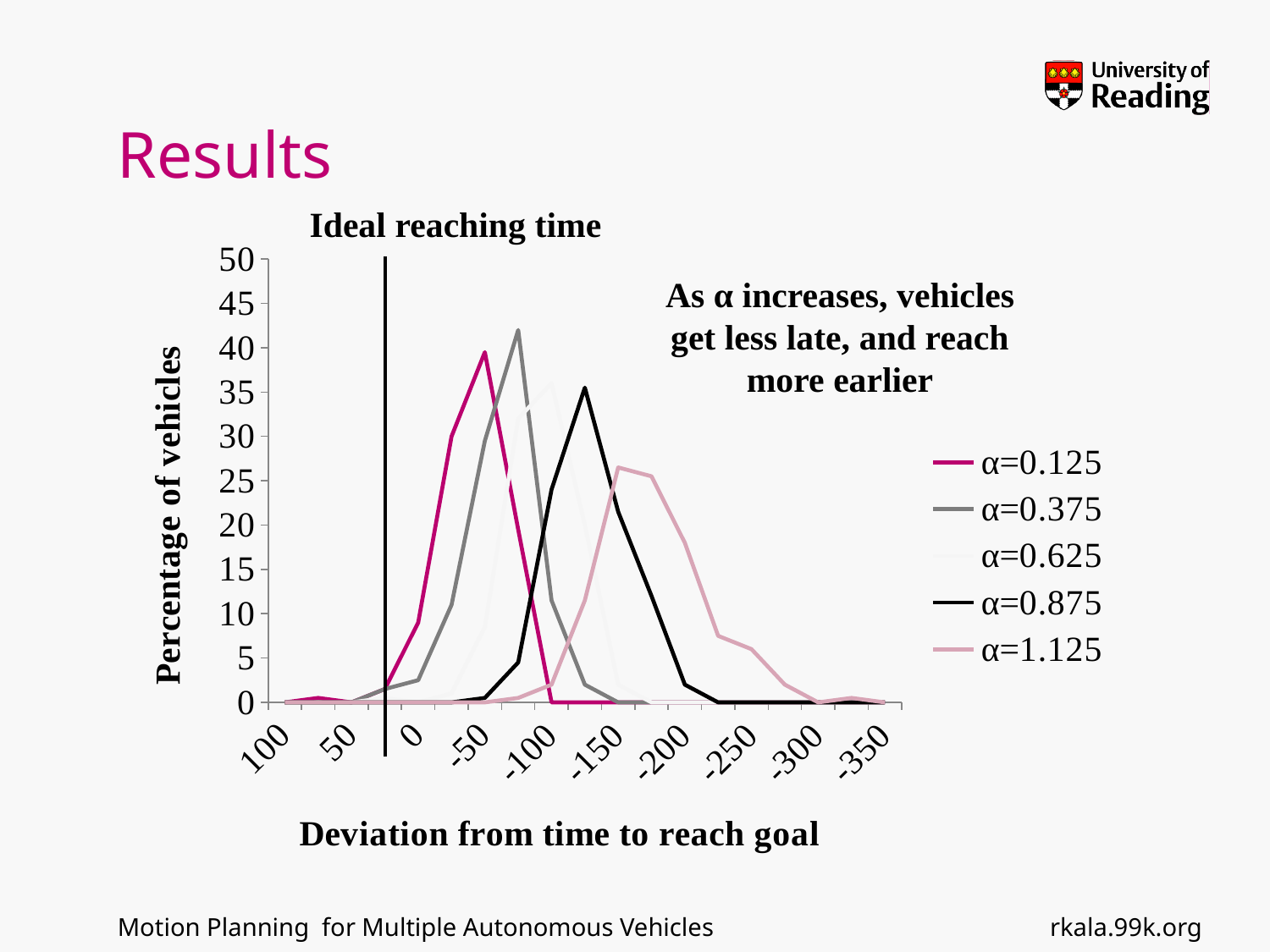
How many tick labels are shown on the x axis? 10 Is the peak value of the α=0.375 series greater or less than 40? greater How many series does the legend list? 5 Which has the larger peak value, the α=0.375 series or the α=1.125 series? α=0.375 Is the peak value of the α=0.625 series greater or less than 30? greater What is the title of the x axis? Deviation from time to reach goal Which series has the lowest peak percentage of vehicles? α=1.125 What kind of chart is shown on the slide? line chart Which series has the highest peak percentage of vehicles? α=0.375 What is the title of the y axis? Percentage of vehicles Is the peak value of the α=1.125 series greater or less than 30? less